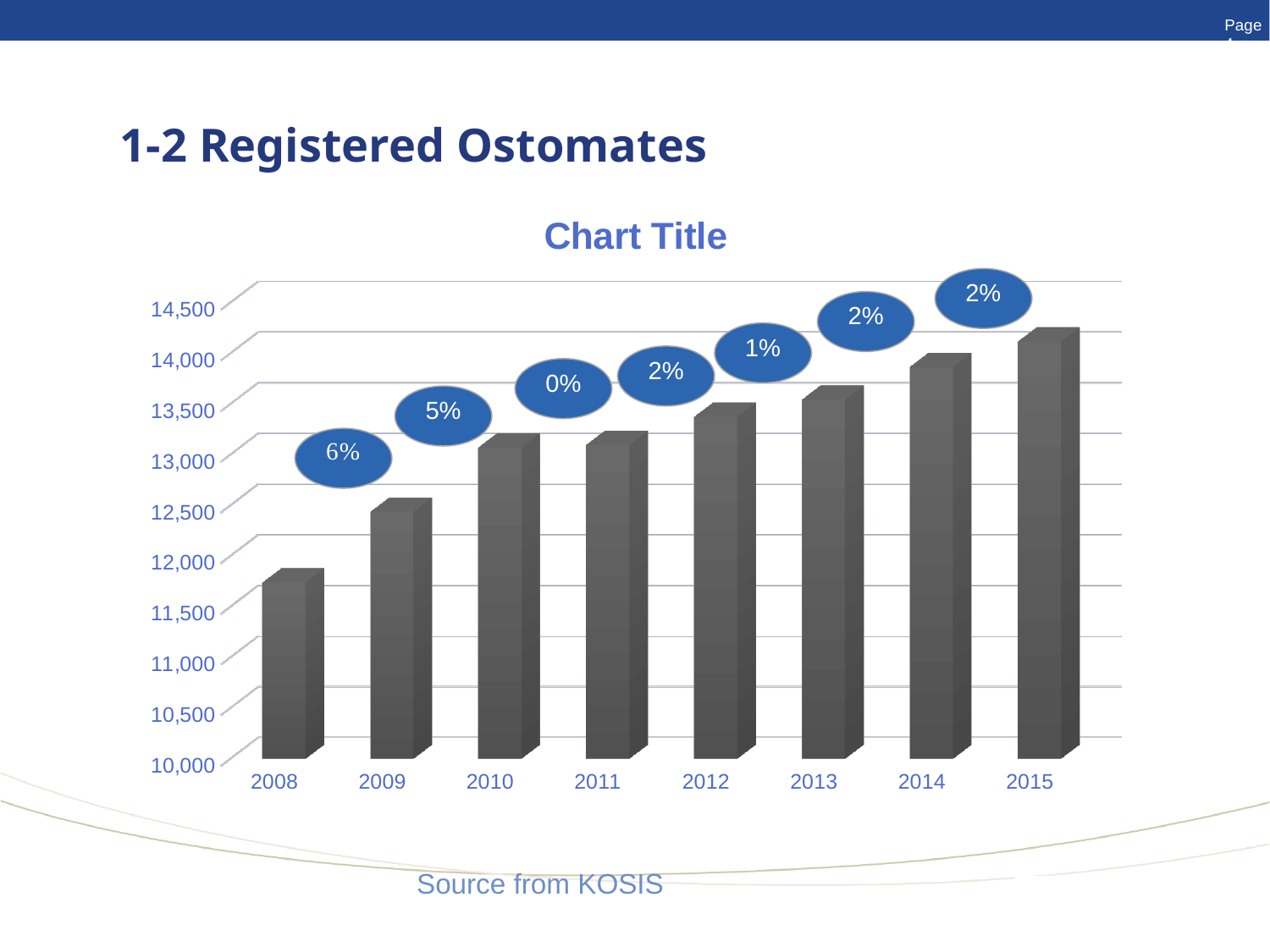
What kind of chart is shown on the slide? bar chart Is the value for 2009 greater or less than 12,000? greater Do the bar values rise or fall from 2008 to 2015? rise Which year has the lowest bar in the chart? 2008 Is the value for 2012 greater or less than 13,000? greater How many years are shown on the x axis of the chart? 8 What percentage is shown in the bubble above the 2009 bar? 5% Which is larger, the value for 2012 or the value for 2009? 2012 Which year has the highest bar in the chart? 2015 Is the value for 2008 greater or less than 12,000? less What is the title shown above the chart? Chart Title